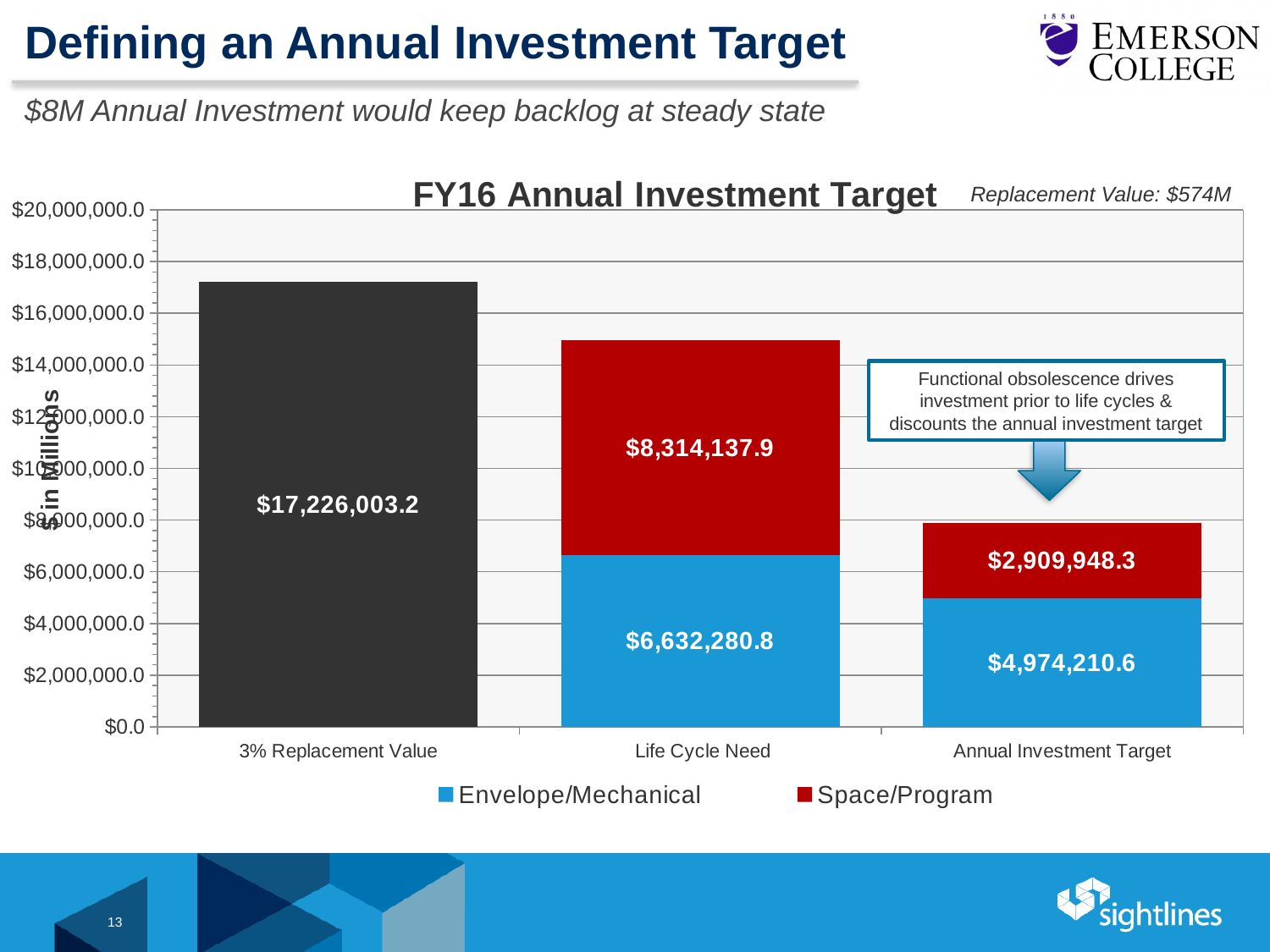
What is the difference between the Space/Program values for Life Cycle Need and Annual Investment Target? $5,404,189.6 What is the total of the stacked bar for Annual Investment Target? $7,884,158.9 How many series does the legend list? 2 What is the Space/Program value for Annual Investment Target? $2,909,948.3 What is the Space/Program value for Life Cycle Need? $8,314,137.9 What is the title of the chart? FY16 Annual Investment Target Which category has the tallest bar overall? 3% Replacement Value What value is labelled on the 3% Replacement Value bar? $17,226,003.2 Which category has the shortest bar overall? Annual Investment Target What is the Envelope/Mechanical value for Life Cycle Need? $6,632,280.8 What is the total of the stacked bar for Life Cycle Need? $14,946,418.7 Which is larger for Life Cycle Need: the Envelope/Mechanical value or the Space/Program value? Space/Program